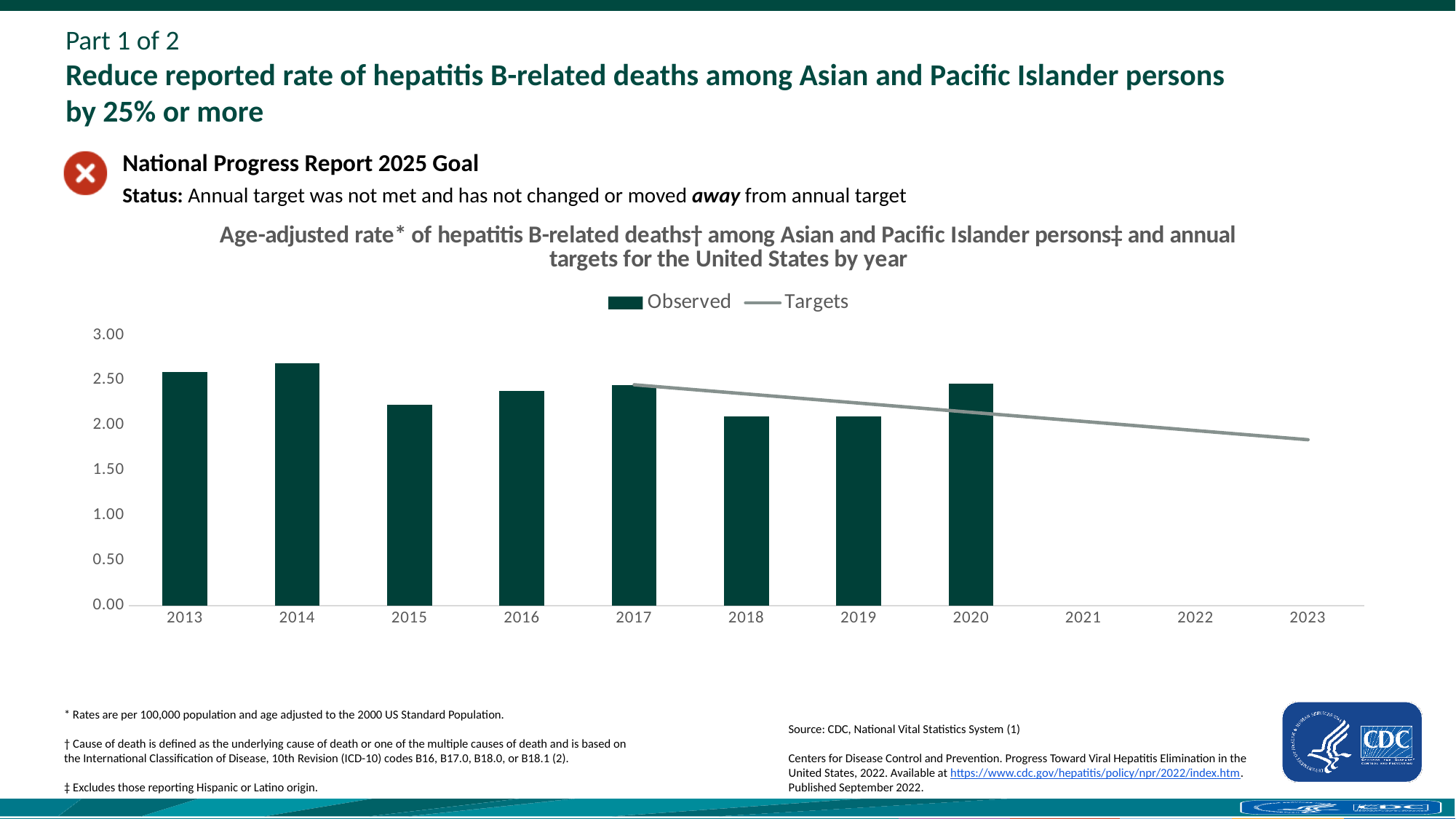
Is the Observed value for 2018 greater or less than 2.50? less How many series does the legend list? 2 What are the two series named in the legend? Observed and Targets How many years are labelled on the x axis? 11 Is the Observed value for 2015 greater or less than 2.00? greater Is the Observed value for 2014 greater or less than 2.50? greater Which year has the highest Observed bar? 2014 What kind of chart is shown on the slide? combination bar and line chart Which is larger, the Observed value for 2020 or for 2019? 2020 Which is larger, the Observed value for 2014 or for 2015? 2014 How many years have an Observed bar plotted? 8 Does the Targets line rise or fall from 2017 to 2023? fall